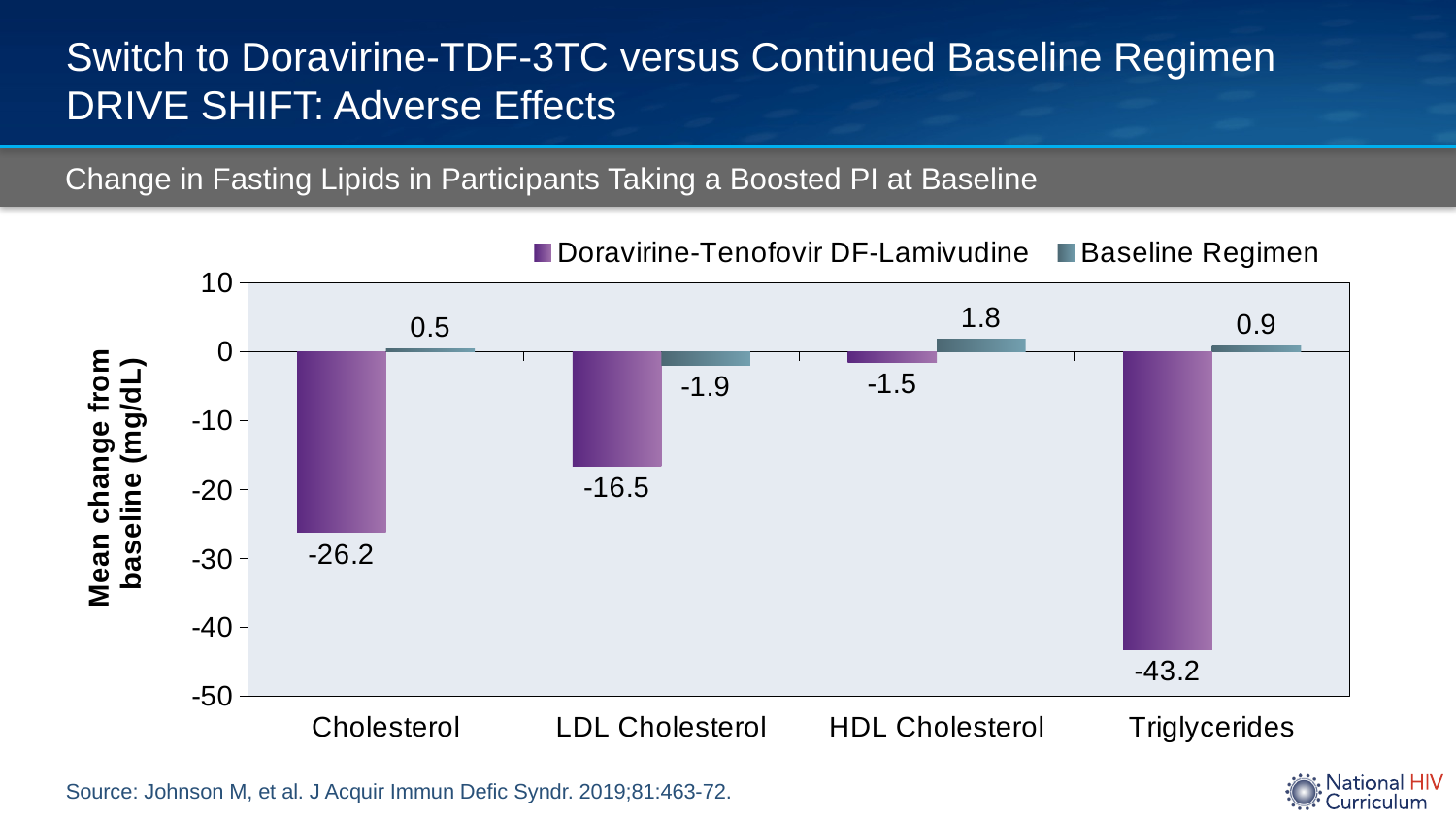
How many lipid categories are shown on the x axis? 4 What is the mean change from baseline in triglycerides for the Baseline Regimen group? 0.9 What kind of chart is shown on the slide? Bar chart What is the mean change from baseline in LDL cholesterol for the Baseline Regimen group? -1.9 What is the mean change from baseline in cholesterol for the Doravirine-Tenofovir DF-Lamivudine group? -26.2 What is the mean change from baseline in HDL cholesterol for the Doravirine-Tenofovir DF-Lamivudine group? -1.5 For which lipid category does the Doravirine-Tenofovir DF-Lamivudine group show the largest decrease from baseline? Triglycerides How many series does the legend list? 2 For which lipid category does the Baseline Regimen group show the highest mean change from baseline? HDL Cholesterol What is the difference between the Doravirine-Tenofovir DF-Lamivudine and Baseline Regimen values for LDL cholesterol? 14.6 What is the label of the y axis? Mean change from baseline (mg/dL)